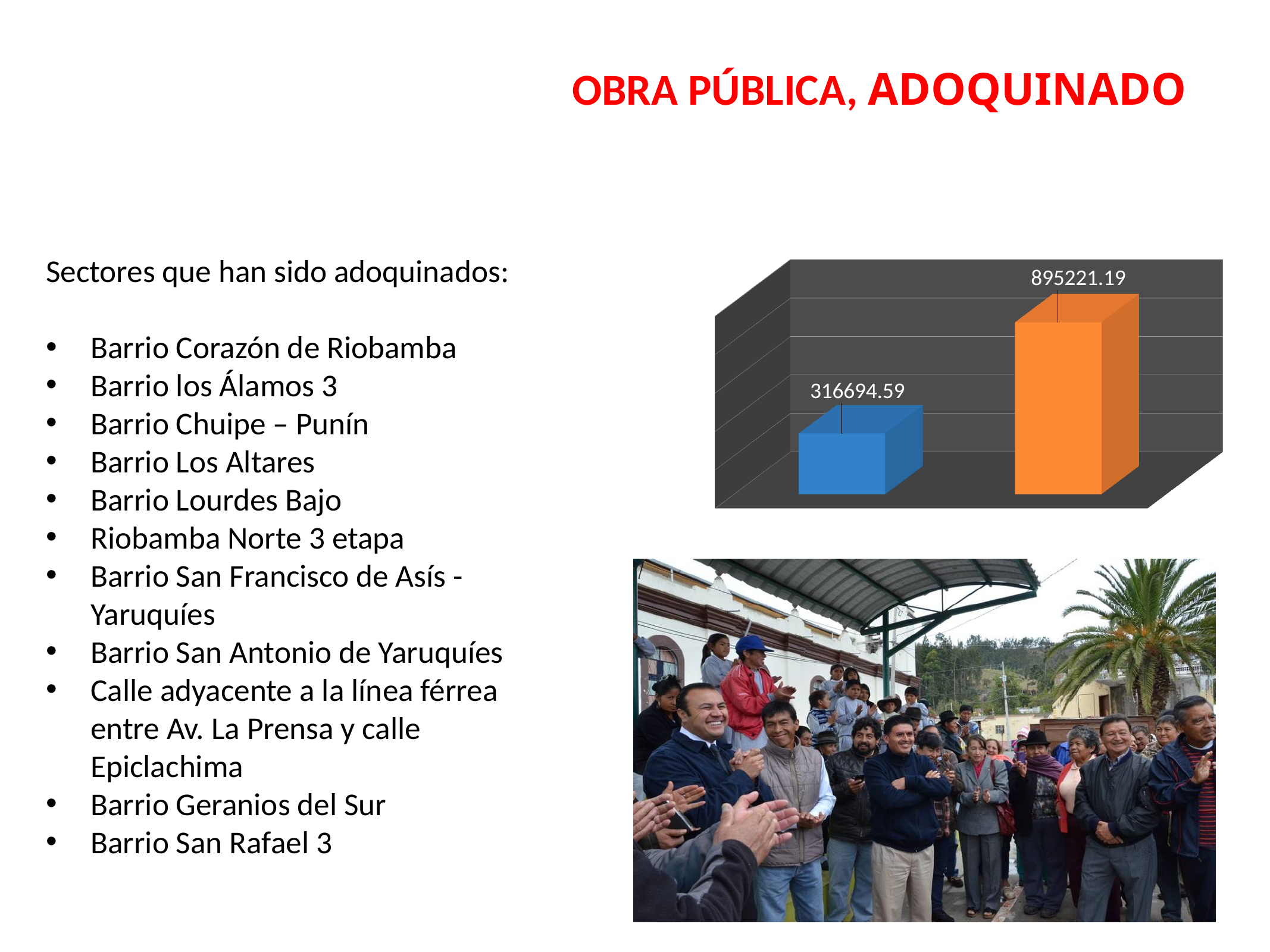
What kind of chart is shown on the slide? bar chart What is the difference between the orange bar's value and the blue bar's value in the chart? 578526.60 Which bar in the chart has the lowest value, the blue one or the orange one? the blue bar What value is shown on the orange bar in the chart? 895221.19 Do the bar values rise or fall from left to right in the chart? rise What colour is the bar with the smaller value in the chart? blue What colour is the bar with the larger value in the chart? orange What value is shown on the blue bar in the chart? 316694.59 Which bar in the chart has the highest value, the blue one or the orange one? the orange bar How many bars are plotted in the chart? 2 Is the value of the left bar larger or smaller than the value of the right bar in the chart? smaller